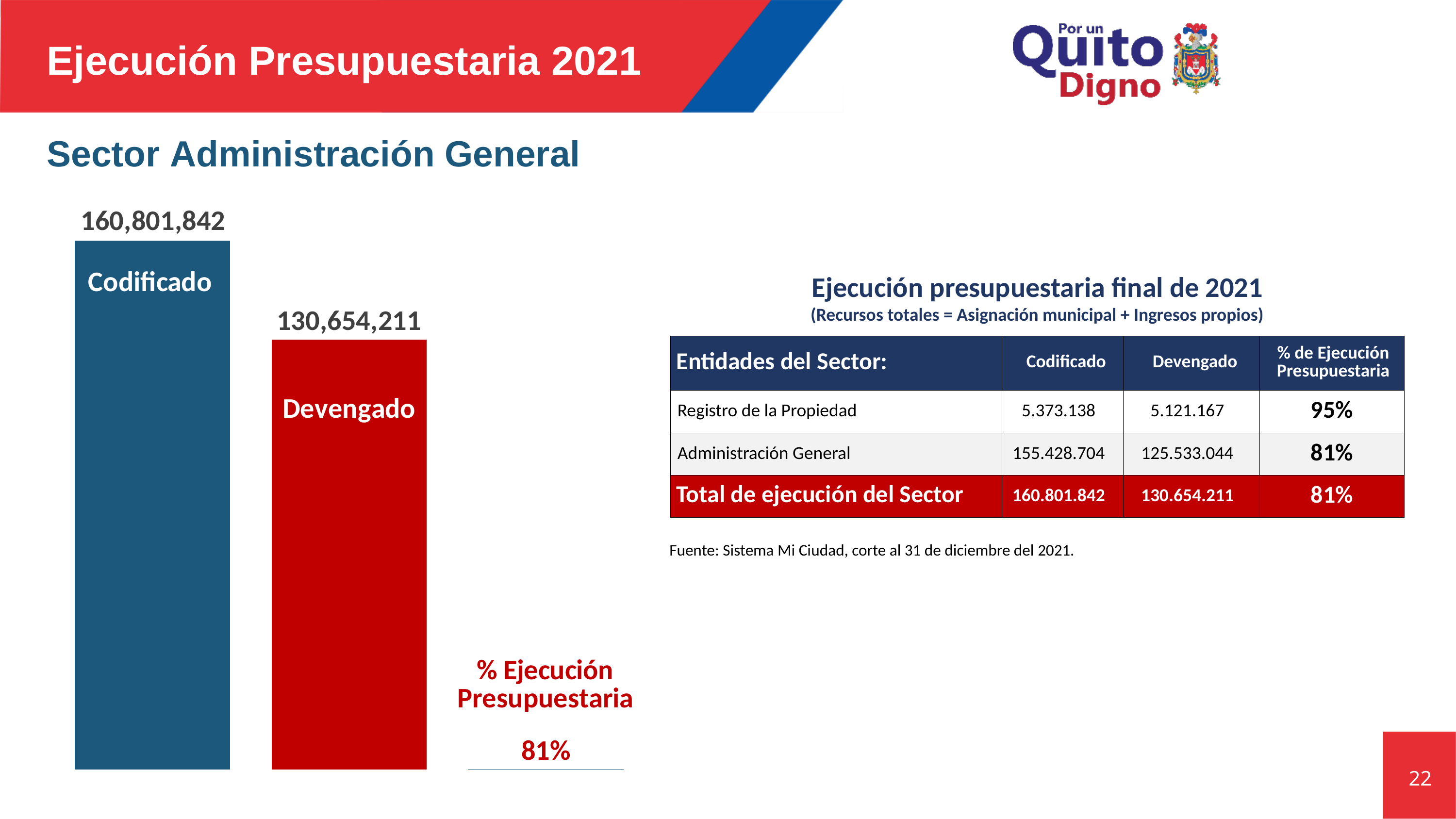
What colour is the Devengado bar? Red Which is larger, Codificado or Devengado? Codificado What kind of chart is shown on the slide? Bar chart What is the value of the Codificado bar? 160,801,842 What is the value of the Devengado bar? 130,654,211 Which bar is the highest in the chart? Codificado What is the difference between the Codificado and Devengado bars? 30,147,631 How many bars are shown in the chart? 2 What percentage of budget execution (% Ejecución Presupuestaria) is shown next to the bars? 81% What colour is the Codificado bar? Blue Which bar is the lowest in the chart? Devengado